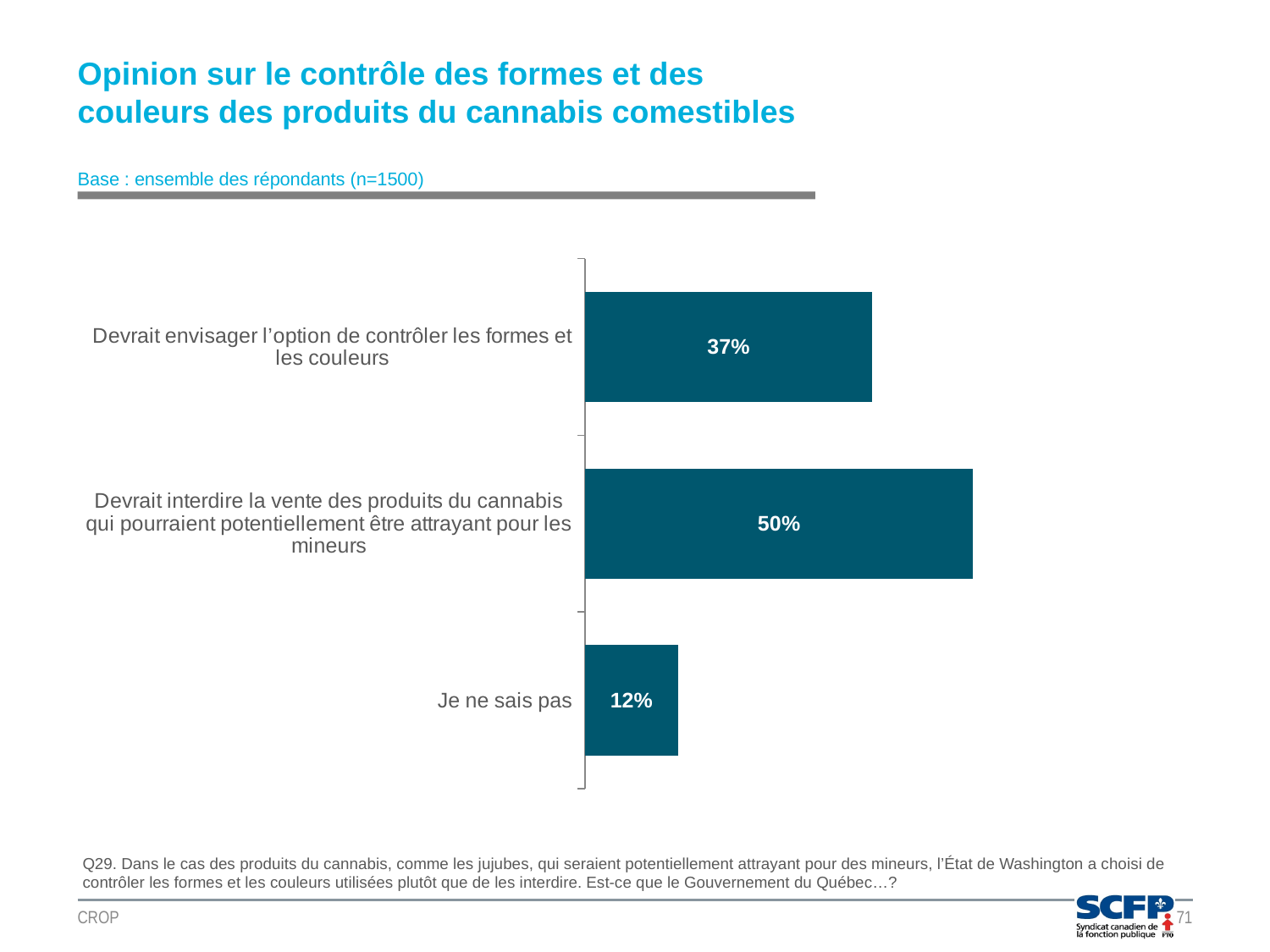
What is the base (sample size) stated for the chart? Ensemble des répondants (n=1500) What is the difference between the "Devrait envisager l'option de contrôler les formes et les couleurs" value and the "Je ne sais pas" value? 25% Which response category has the highest value? Devrait interdire la vente des produits du cannabis qui pourraient potentiellement être attrayant pour les mineurs What is the value for "Devrait interdire la vente des produits du cannabis qui pourraient potentiellement être attrayant pour les mineurs"? 50% Which response category has the lowest value? Je ne sais pas What percentage of respondents said the government should consider the option of controlling shapes and colours ("Devrait envisager l'option de contrôler les formes et les couleurs")? 37% What is the difference between the "Devrait interdire la vente..." value and the "Devrait envisager l'option de contrôler..." value? 13% What is the title of the chart on the slide? Opinion sur le contrôle des formes et des couleurs des produits du cannabis comestibles What type of chart is shown on the slide? Bar chart How many response categories are shown in the chart? 3 Which is larger: the value for "Devrait envisager l'option de contrôler les formes et les couleurs" or the value for "Je ne sais pas"? Devrait envisager l'option de contrôler les formes et les couleurs What percentage of respondents answered "Je ne sais pas"? 12%